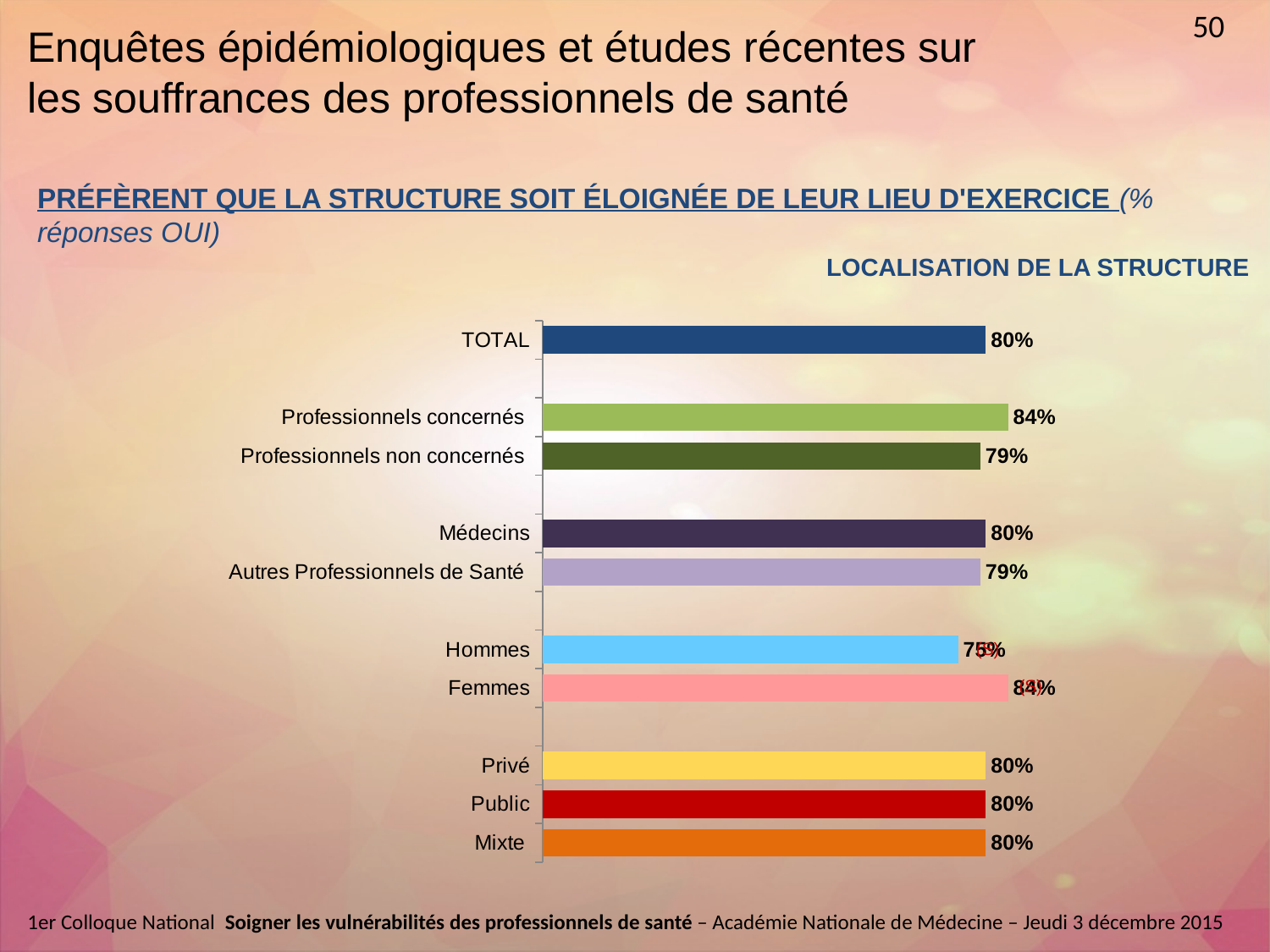
What is the title of the chart? LOCALISATION DE LA STRUCTURE What type of chart is shown on the slide? bar chart How many categories are shown in the chart? 10 What is the value for Mixte? 80% What is the value for TOTAL? 80% What is the value for Professionnels non concernés? 79% What is the difference between the values for Professionnels concernés and Professionnels non concernés? 5 percentage points What is the value for Autres Professionnels de Santé? 79% Which is larger, the value for Hommes or the value for Femmes? Femmes What is the value for Professionnels concernés? 84% What is the difference between the values for Médecins and Autres Professionnels de Santé? 1 percentage point Which category has the lowest value? Hommes